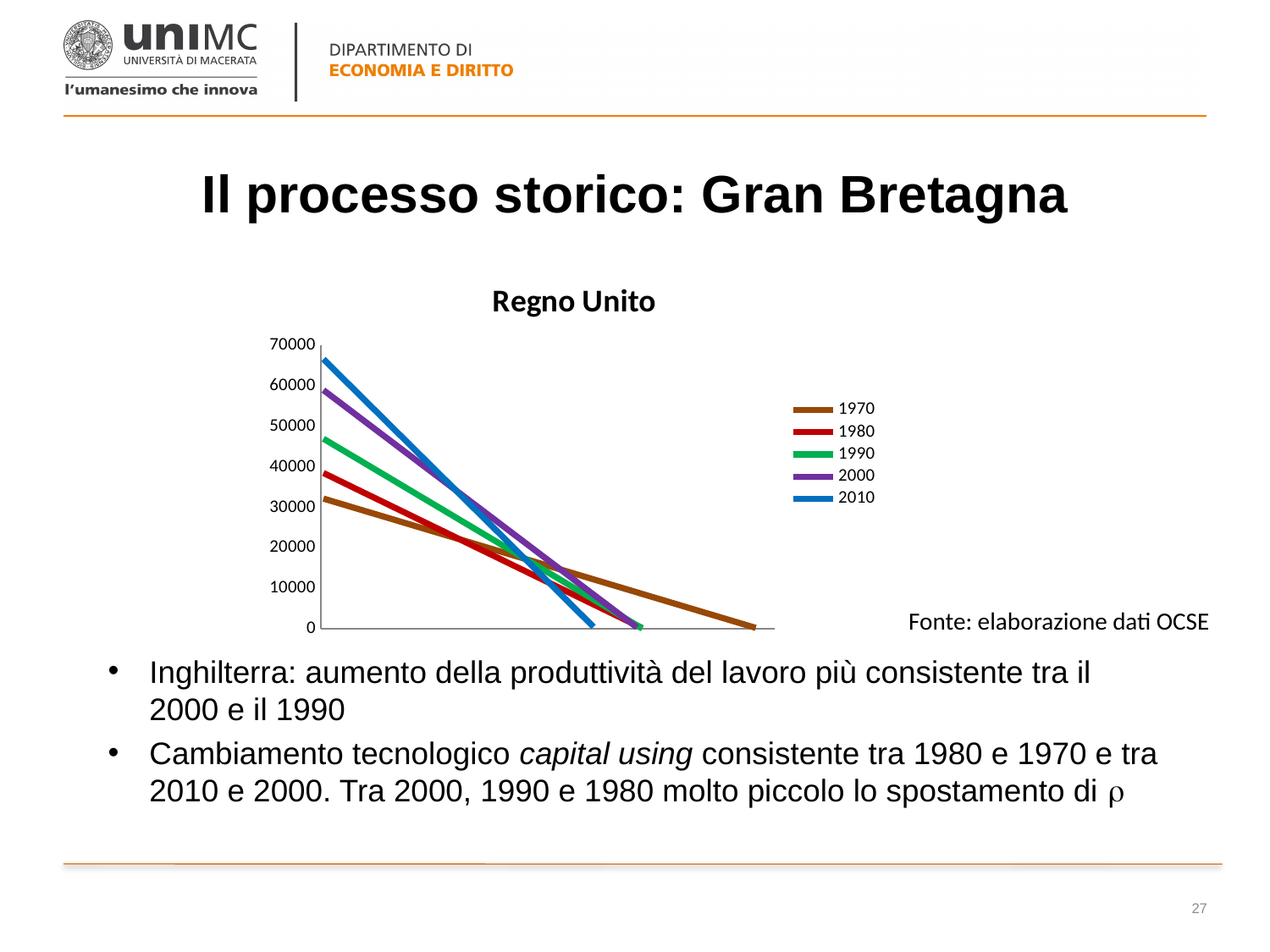
Do the lines rise or fall as they move to the right along the x axis? fall Which line starts higher on the vertical axis, 2010 or 1970? 2010 Which years are listed in the chart's legend? 1970, 1980, 1990, 2000, 2010 Which series starts at the lowest value on the vertical axis? 1970 Is the starting value of the 2010 line greater or less than 60000? greater Is the starting value of the 1990 line greater or less than 40000? greater Is the starting value of the 1970 line greater or less than 40000? less How many series does the legend of the chart list? 5 What kind of chart is shown on the slide? line chart Which series starts at the highest value on the vertical axis? 2010 What is the title of the chart? Regno Unito Which series reaches zero furthest to the right on the horizontal axis? 1970